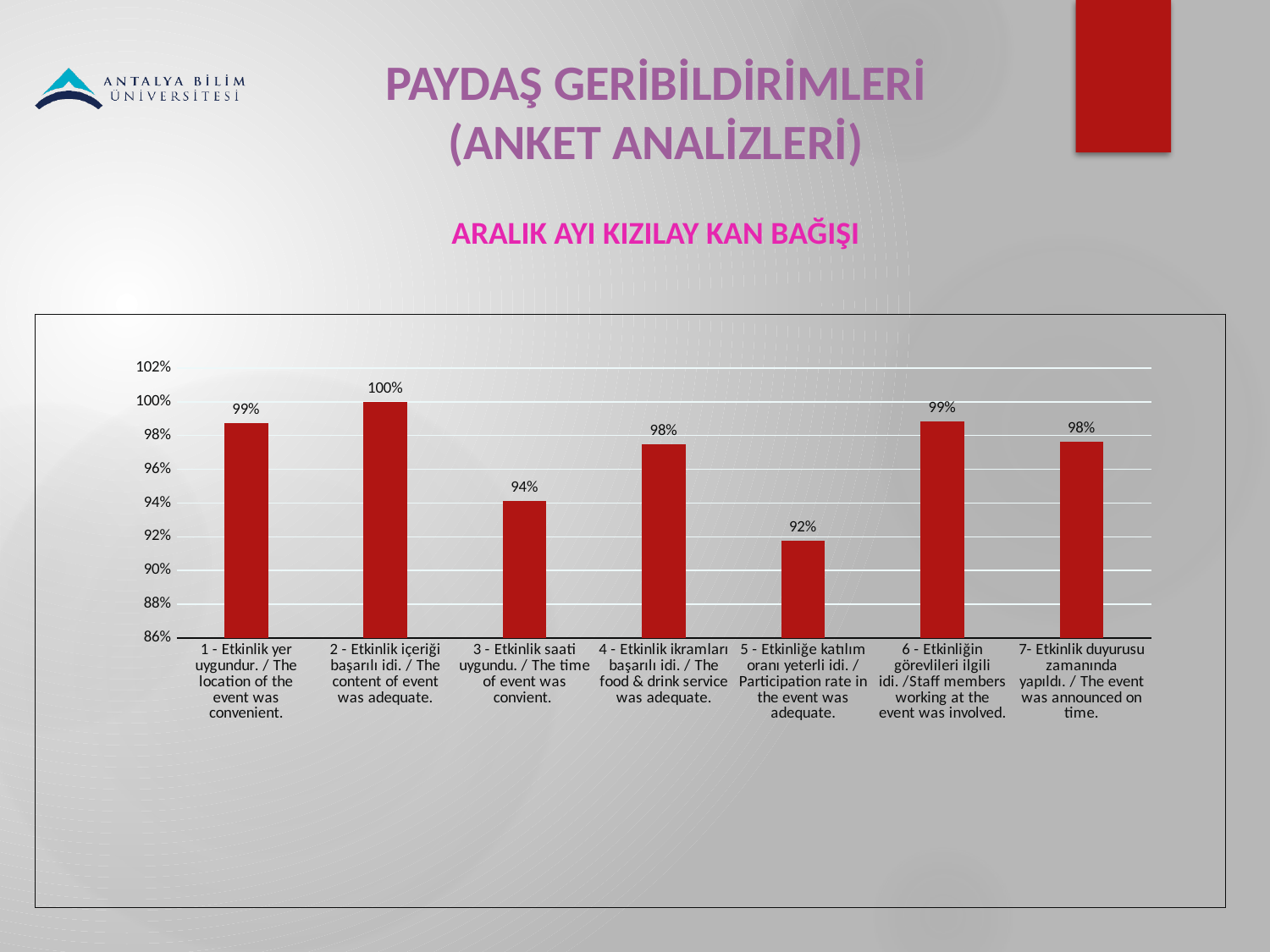
What colour are the bars in the chart? red What is the value for "5 - Etkinliğe katılım oranı yeterli idi. / Participation rate in the event was adequate."? 92% What is the difference between the value for category 2 (content of event) and the value for category 5 (participation rate)? 8% What is the value for "3 - Etkinlik saati uygundu. / The time of event was convient."? 94% How many categories are shown in the chart? 7 Is the value for category 5 (participation rate) greater or less than 94%? less Which category has the highest value? 2 - Etkinlik içeriği başarılı idi. / The content of event was adequate. What is the value for "1 - Etkinlik yer uygundur. / The location of the event was convenient."? 99% Which category has the lowest value? 5 - Etkinliğe katılım oranı yeterli idi. / Participation rate in the event was adequate. What is the value for "7- Etkinlik duyurusu zamanında yapıldı. / The event was announced on time."? 98% Which is larger: the value for category 3 (time of event) or the value for category 4 (food & drink service)? 4 - Etkinlik ikramları başarılı idi. / The food & drink service was adequate. What kind of chart is shown on the slide? bar chart